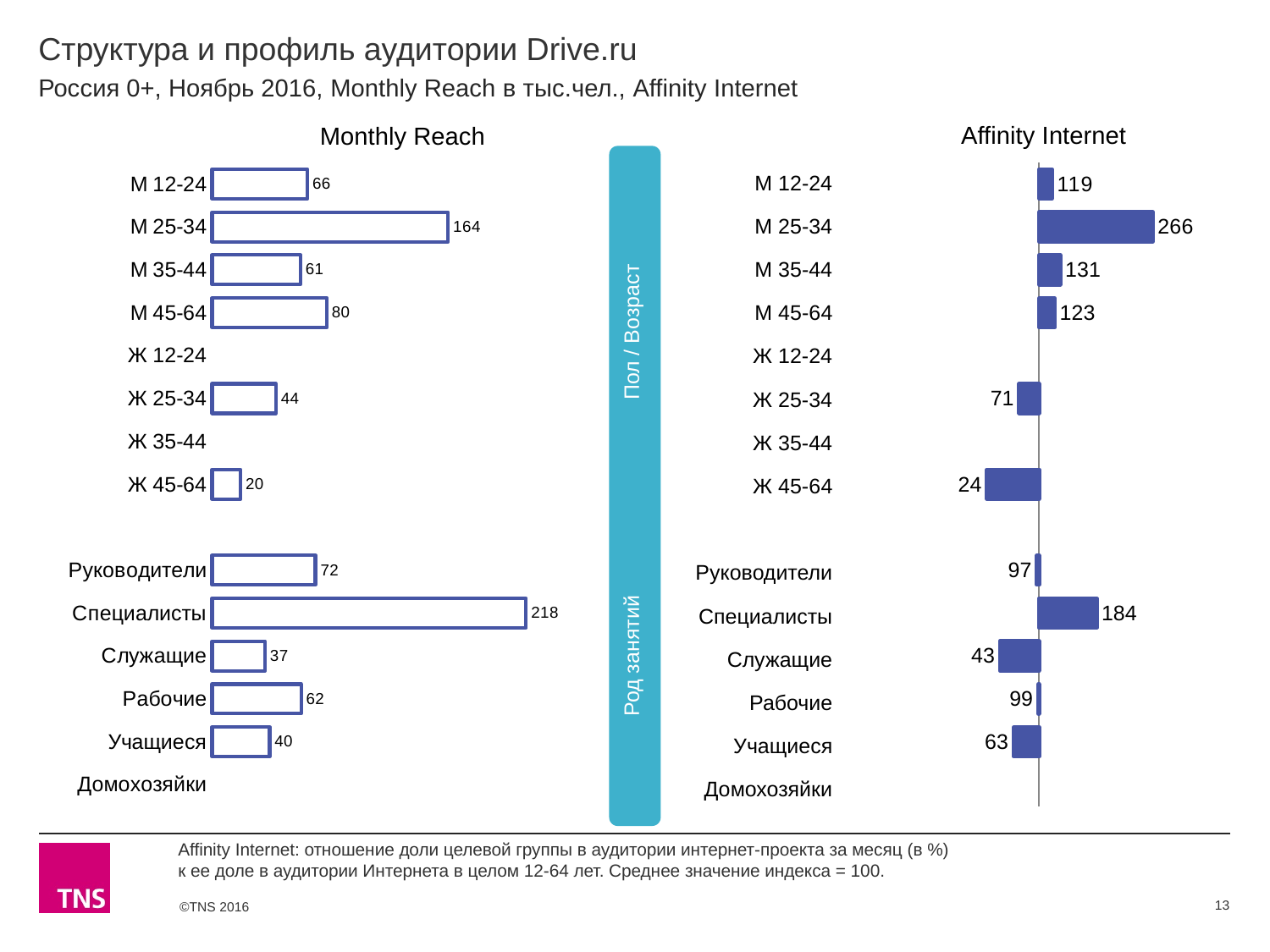
In the Monthly Reach chart, what is the difference between the values for М 25-34 and М 12-24? 98 What kind of chart is the Monthly Reach chart? Bar chart In the Monthly Reach chart, what is the value for М 25-34? 164 In the Affinity Internet chart, what is the difference between the values for М 25-34 and Специалисты? 82 In the Affinity Internet chart, what is the value for Рабочие? 99 In the Affinity Internet chart, what is the value for Специалисты? 184 In the Affinity Internet chart, which is larger: the value for М 35-44 or the value for М 45-64? М 35-44 In the Monthly Reach chart, which category has the highest value? Специалисты In the Affinity Internet chart, which category has the lowest value among those with a printed value? Ж 45-64 In the Monthly Reach chart, which is larger: the value for Руководители or the value for Рабочие? Руководители In the Monthly Reach chart, what is the value for Учащиеся? 40 In the Affinity Internet chart, what is the value for Ж 25-34? 71